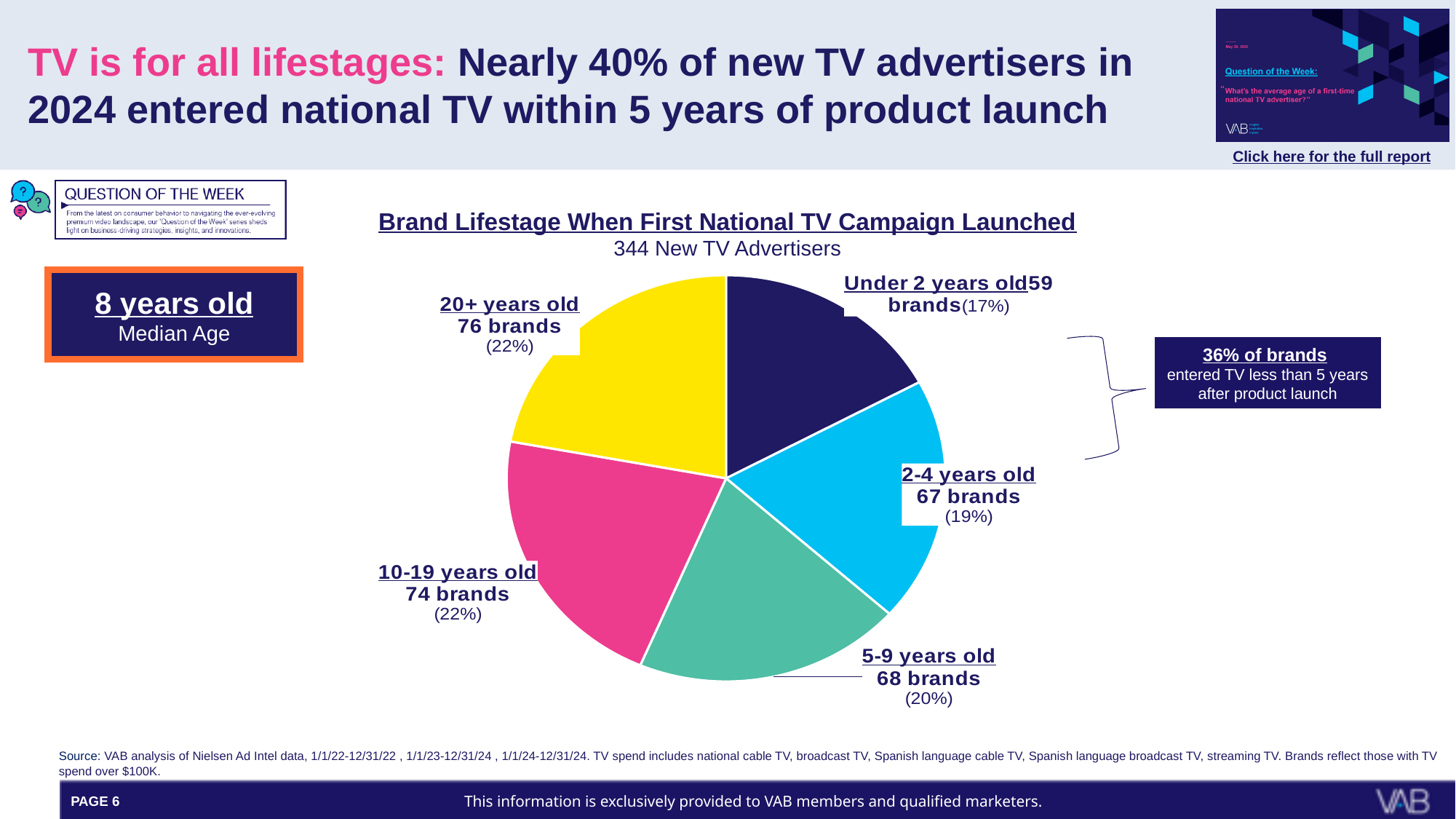
How many more brands are in the '10-19 years old' slice than in the '2-4 years old' slice? 7 What share of the pie does the '10-19 years old' slice represent? 22% How many lifestage categories are shown in the pie chart? 5 How many brands are in the 'Under 2 years old' slice of the pie chart? 59 brands Which lifestage category has the most brands? 20+ years old How many more brands are in the '20+ years old' slice than in the 'Under 2 years old' slice? 17 What is the title of the pie chart? Brand Lifestage When First National TV Campaign Launched Which lifestage category has the fewest brands? Under 2 years old How many brands are in the '5-9 years old' slice? 68 brands What type of chart is shown on the slide? Pie chart Which has more brands: '20+ years old' or 'Under 2 years old'? 20+ years old What share of the pie does the '2-4 years old' slice represent? 19%